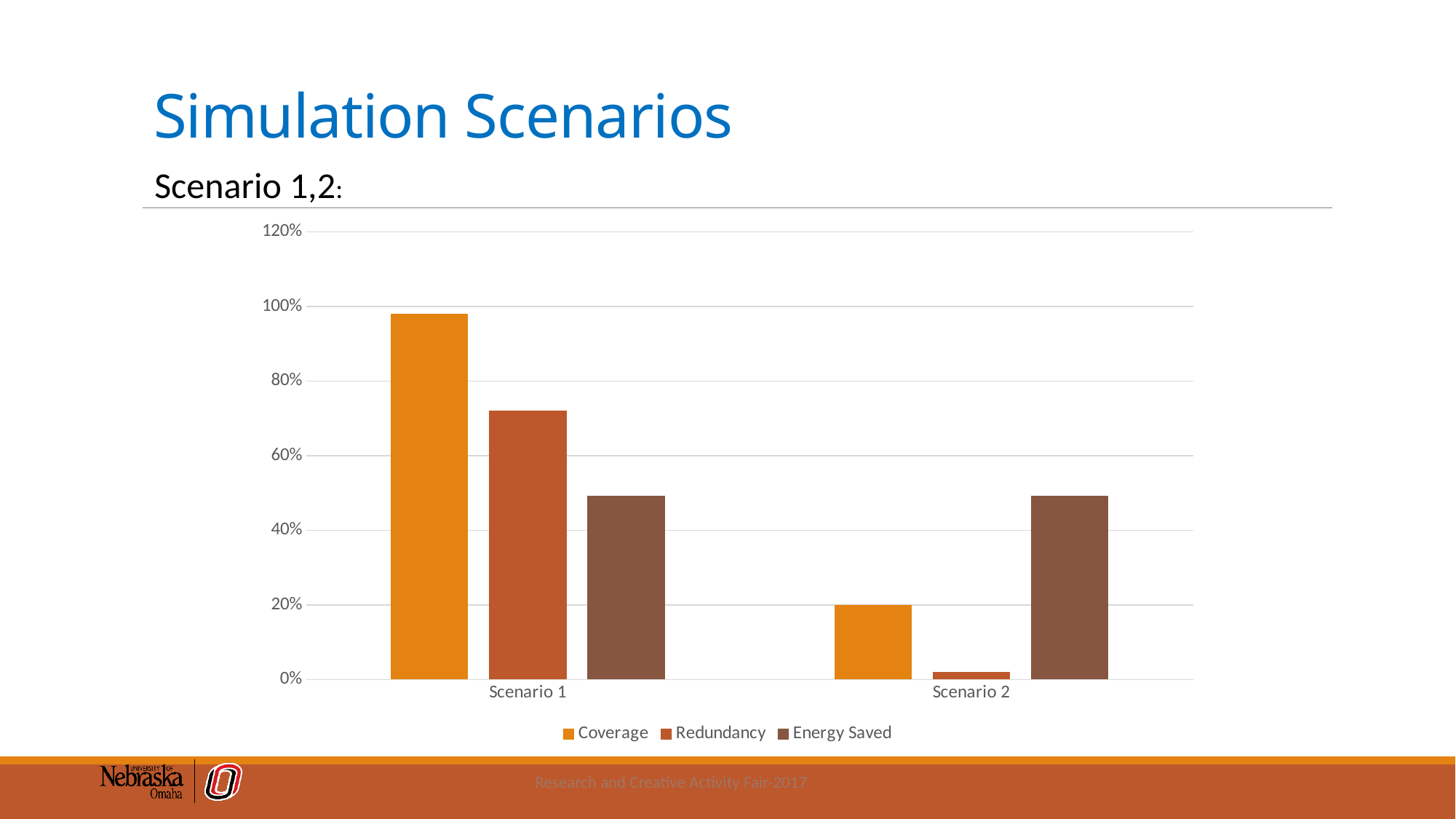
Which series has the lowest value in Scenario 2? Redundancy How many series does the legend list? 3 Which series has the highest value in Scenario 2? Energy Saved How many scenario categories are shown on the x axis? 2 Is the Coverage value for Scenario 1 greater or less than 80%? greater What kind of chart is shown on the slide? bar chart Is the Redundancy value for Scenario 1 greater or less than 60%? greater Which is larger: Coverage in Scenario 1 or Coverage in Scenario 2? Coverage in Scenario 1 Is the Redundancy value for Scenario 2 greater or less than 20%? less What is the name of the series shown in the darkest brown colour? Energy Saved Which is larger: Redundancy in Scenario 1 or Energy Saved in Scenario 1? Redundancy in Scenario 1 Which series has the highest value in Scenario 1? Coverage